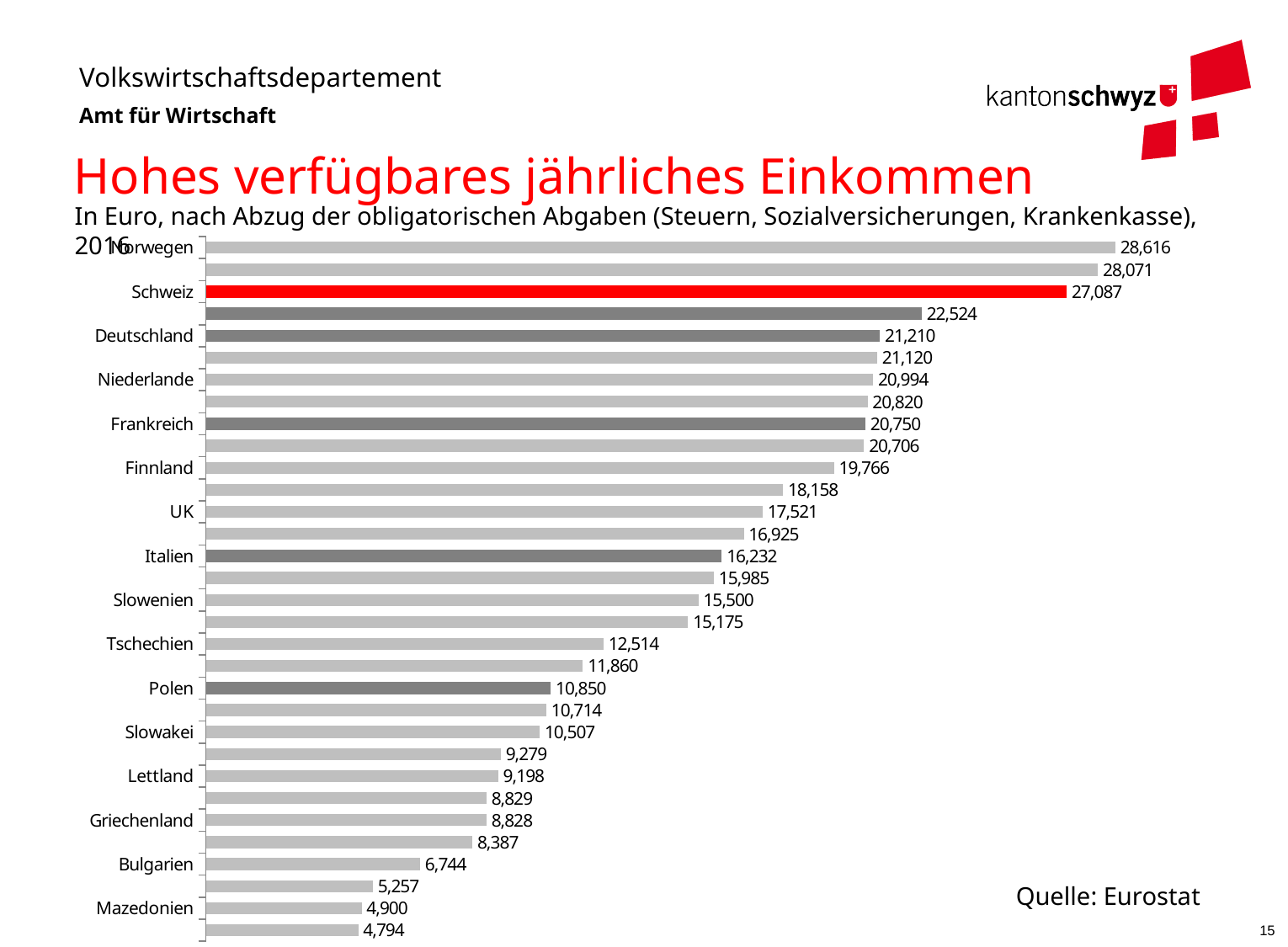
How many bars are shown in the chart? 32 Which country's bar is highlighted in red? Schweiz What is the value for Deutschland? 21,210 What is the difference between the values for Schweiz and Deutschland? 5,877 What is the difference between the values for Norwegen and Schweiz? 1,529 What is the value for Mazedonien? 4,900 What is the lowest value shown in the chart? 4,794 Which country has the highest value? Norwegen What is the value for Polen? 10,850 What is the value for Schweiz? 27,087 What kind of chart is shown? Bar chart Which has a larger value, Frankreich or Finnland? Frankreich